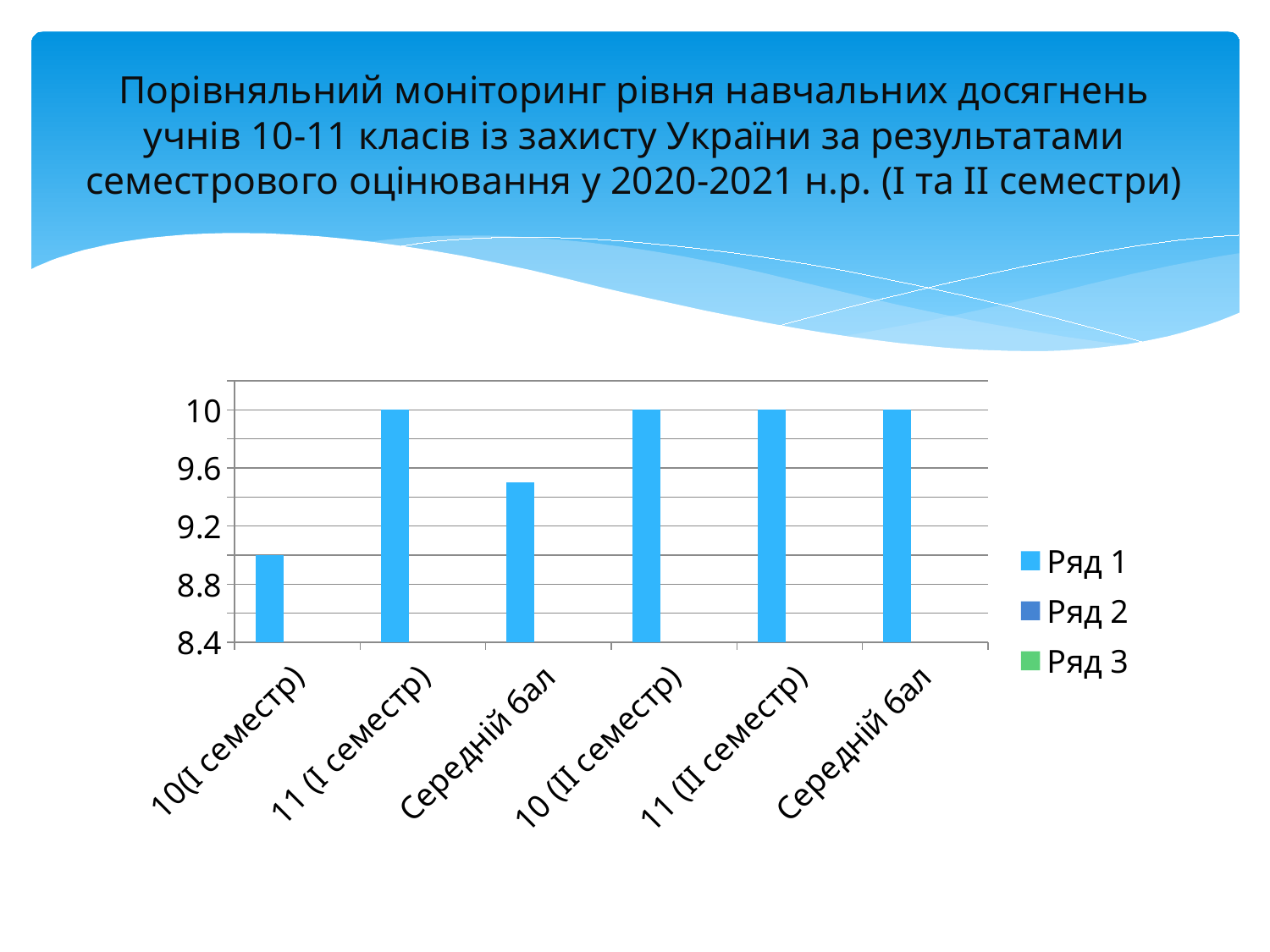
What type of chart is shown on the slide? bar chart What is the value for 10 (II семестр)? 10 Which series in the legend do the visible bars belong to? Ряд 1 What is the value for 11 (II семестр)? 10 How many categories are shown on the x axis of the chart? 6 Is the value for 10(I семестр) greater or less than 9.2? less Which category has the lowest value? 10(I семестр) Which is larger, the value for the first Середній бал or the value for 10 (II семестр)? 10 (II семестр) How many series does the chart legend list? 3 What is the value for 11 (I семестр)? 10 Is the value for the first Середній бал (I семестр) greater or less than 9.2? greater Which is larger, the value for 10(I семестр) or the value for 11 (I семестр)? 11 (I семестр)